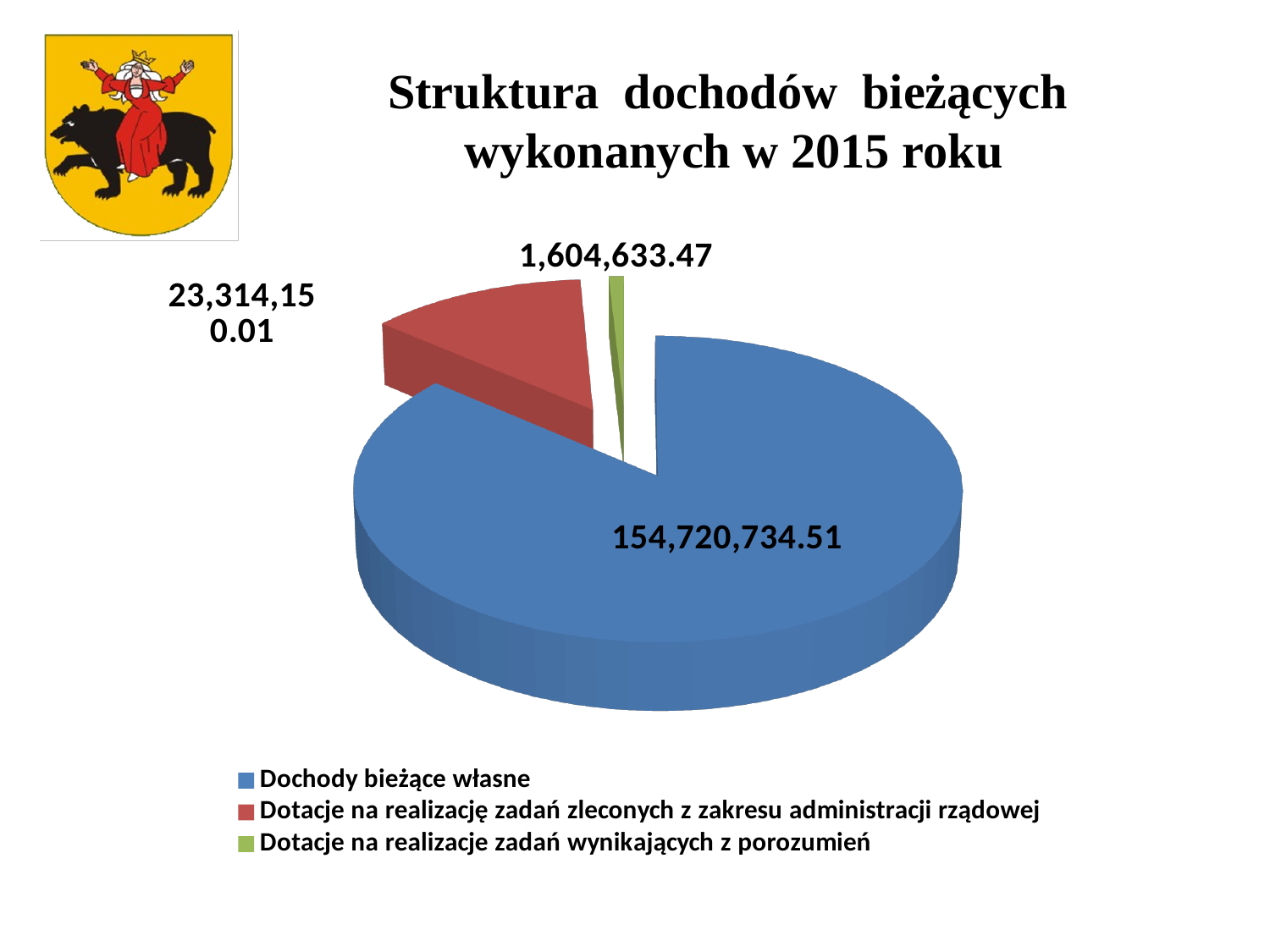
Which category has the smallest slice of the pie? Dotacje na realizacje zadań wynikających z porozumień How many slices does the pie chart have? 3 What is the difference between the value for Dochody bieżące własne and the value for Dotacje na realizację zadań zleconych z zakresu administracji rządowej? 131,406,584.50 Which category has the largest slice of the pie? Dochody bieżące własne What type of chart is shown on the slide? Pie chart How many entries does the legend list? 3 What is the value for Dotacje na realizacje zadań wynikających z porozumień? 1,604,633.47 What is the value for Dotacje na realizację zadań zleconych z zakresu administracji rządowej? 23,314,150.01 Which is larger: the value for Dotacje na realizację zadań zleconych z zakresu administracji rządowej or the value for Dotacje na realizacje zadań wynikających z porozumień? Dotacje na realizację zadań zleconych z zakresu administracji rządowej What is the value for Dochody bieżące własne? 154,720,734.51 What colour is the slice for Dochody bieżące własne? Blue What is the title of the chart? Struktura dochodów bieżących wykonanych w 2015 roku